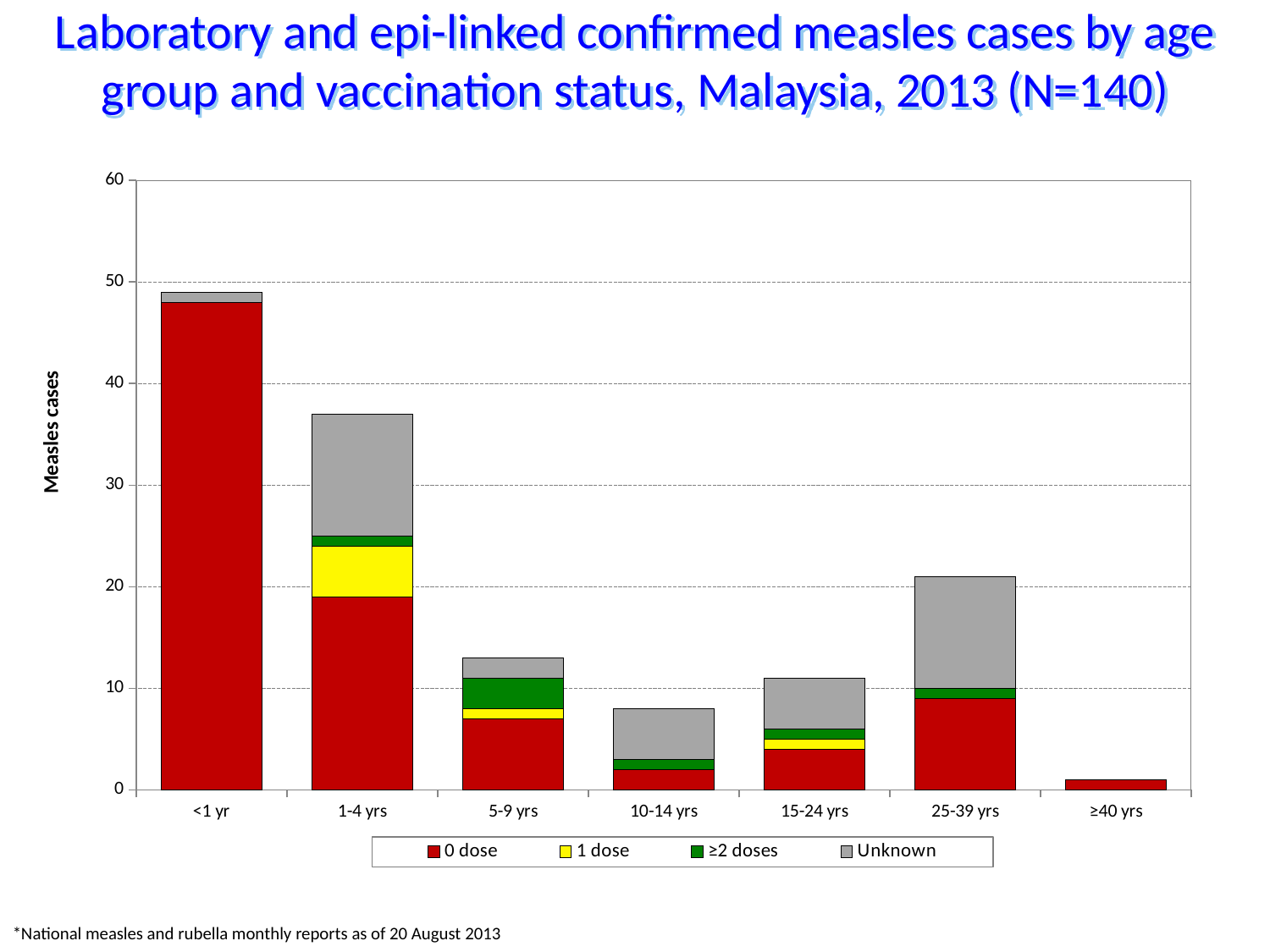
What is the label on the y axis of the chart? Measles cases Is the total number of measles cases for the 10-14 yrs age group greater or less than 10? less Which age group has more total measles cases, 1-4 yrs or 25-39 yrs? 1-4 yrs Which age group has the lowest total number of measles cases? ≥40 yrs How many vaccination status series does the legend list? 4 Is the total number of measles cases for the 1-4 yrs age group greater or less than 40? less Which age group has the highest total number of measles cases? <1 yr How many age groups are shown on the x axis? 7 Is the number of 0 dose measles cases in the <1 yr age group greater or less than 40? greater What kind of chart is shown on the slide? Stacked bar chart Which age group has more total measles cases, 5-9 yrs or 10-14 yrs? 5-9 yrs